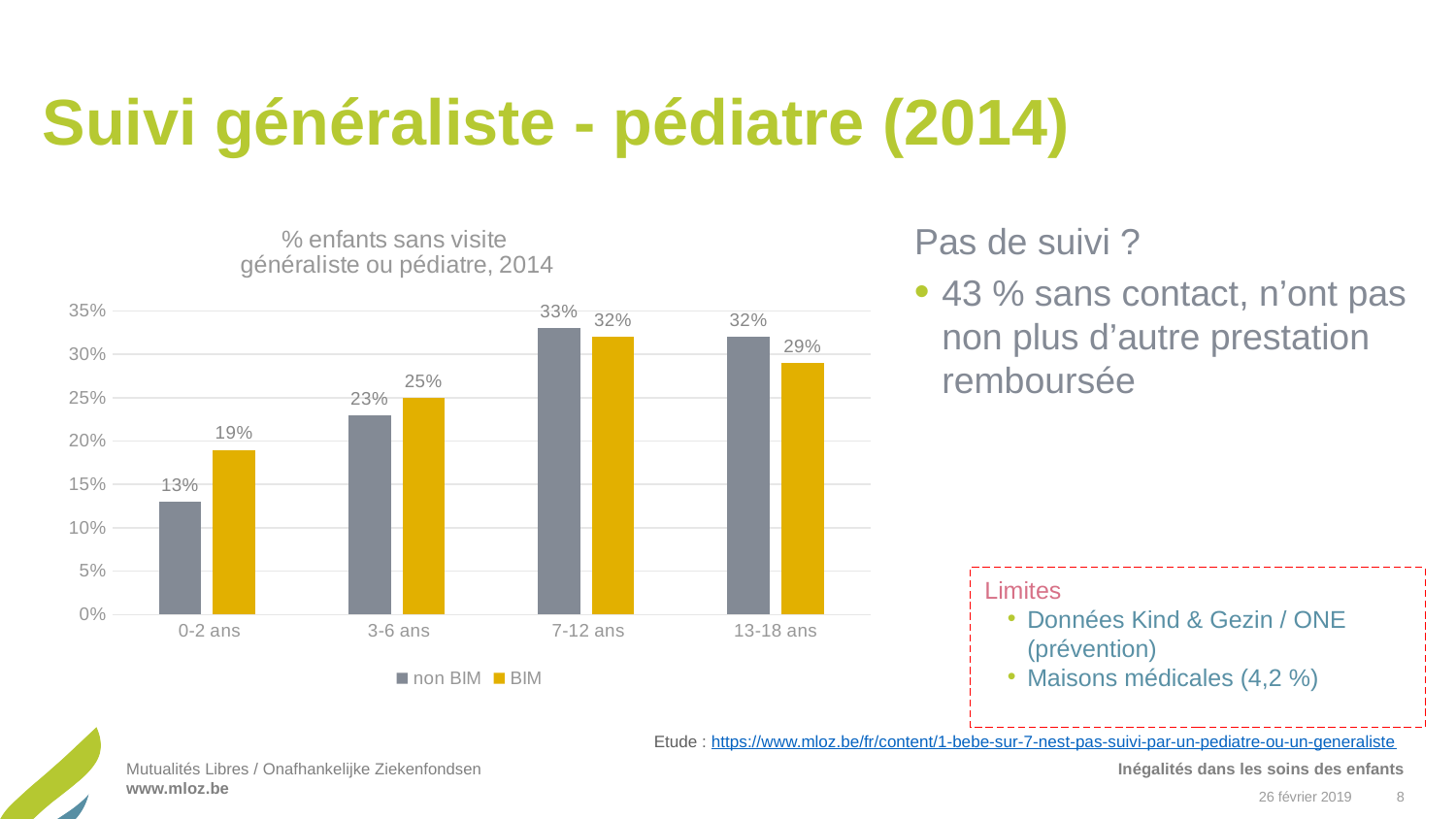
What is the value for non BIM in the 0-2 ans category? 13% Does the non BIM value rise or fall from 0-2 ans to 7-12 ans? rise How many series does the legend list? 2 Which age category has the highest non BIM value? 7-12 ans Which is larger for 13-18 ans, non BIM or BIM? non BIM What is the difference between the BIM and non BIM values for 0-2 ans? 6% What kind of chart is shown on the slide? bar chart What is the value for BIM in the 13-18 ans category? 29% What is the value for BIM in the 3-6 ans category? 25% How many age categories are shown on the x axis? 4 Which age category has the lowest BIM value? 0-2 ans What is the title of the chart? % enfants sans visite généraliste ou pédiatre, 2014